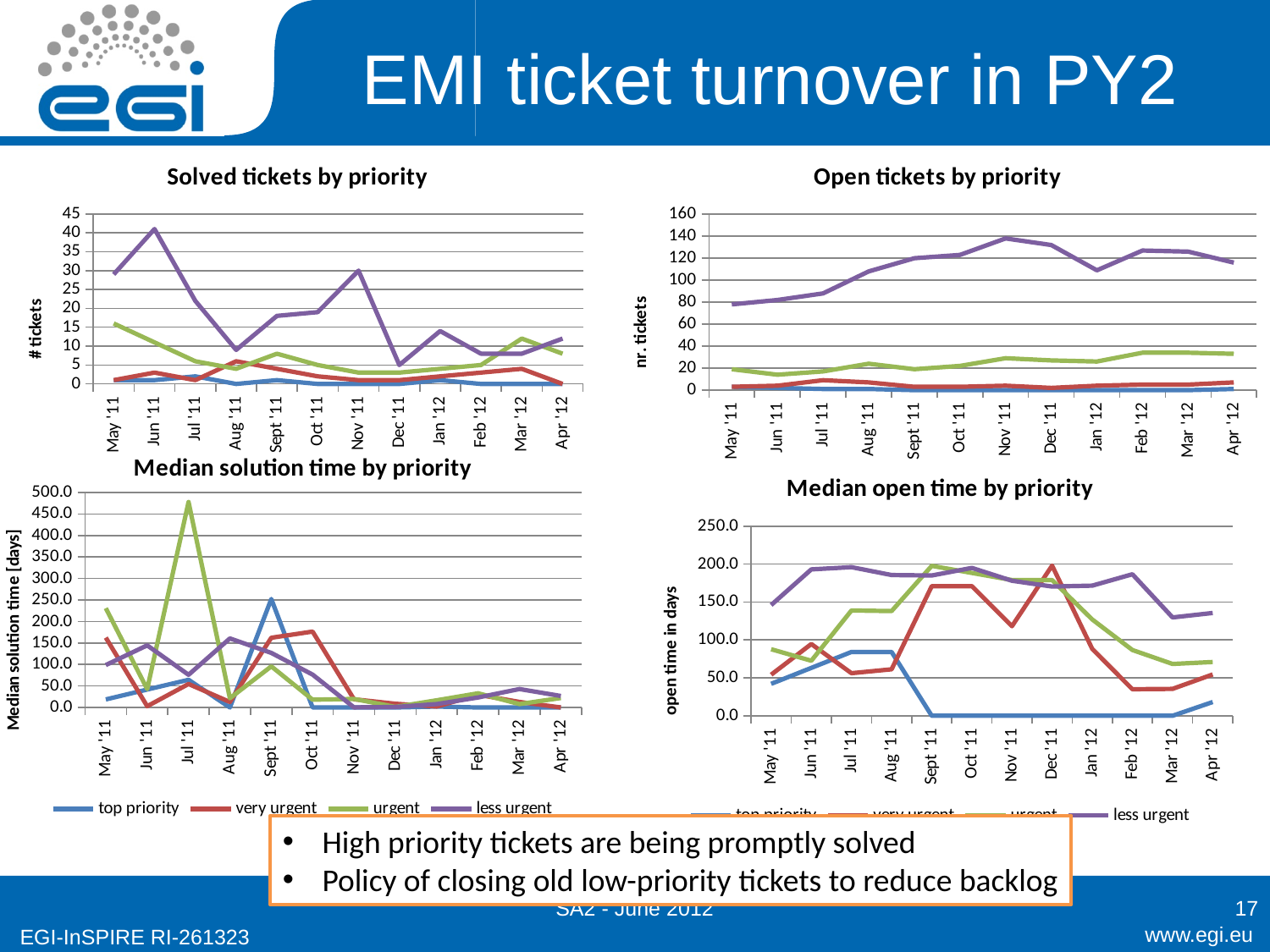
In the "Median open time by priority" chart, is the value for very urgent in Dec '11 greater or less than 150? greater What kind of chart is the "Solved tickets by priority" chart? line chart What is the y-axis label of the "Median open time by priority" chart? open time in days In the "Solved tickets by priority" chart, is the value for less urgent in Jun '11 greater or less than 35? greater In the "Open tickets by priority" chart, is the value for less urgent in Nov '11 greater or less than 120? greater In the "Open tickets by priority" chart, which series has the highest values throughout the period? less urgent In the "Median solution time by priority" chart, in which month does the urgent series peak? Jul '11 How many series does the legend list for the "Median solution time by priority" chart? 4 In the "Solved tickets by priority" chart, in which month does the less urgent series reach its highest value? Jun '11 In the "Open tickets by priority" chart, does the less urgent series generally rise or fall from May '11 to Nov '11? rise How many months are plotted along the x axis of the "Open tickets by priority" chart? 12